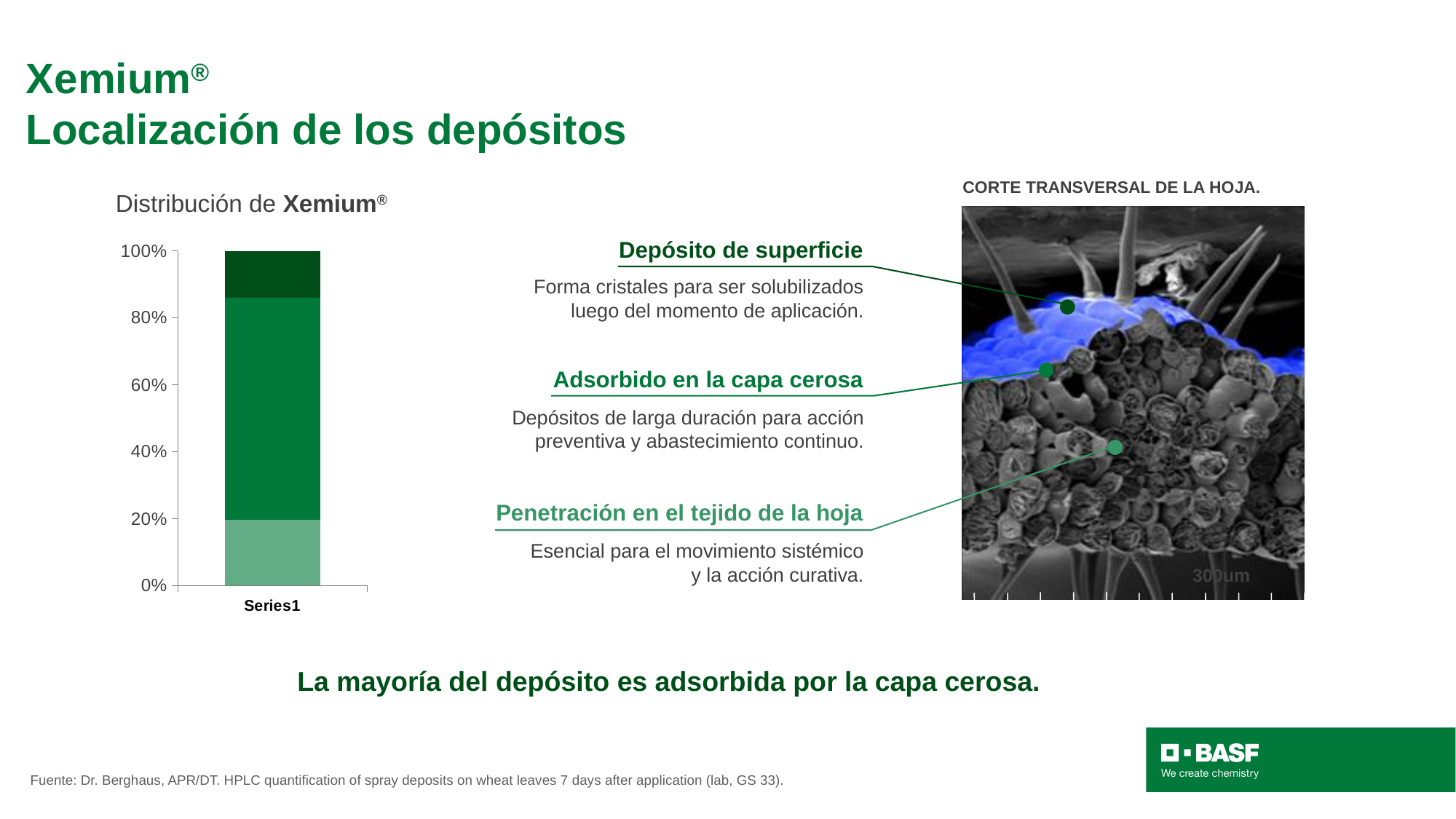
What is the title of the chart on the slide? Distribución de Xemium® Is the middle (medium green) segment of the bar larger or smaller than the bottom (light green) segment? larger What is the label of the single category on the x axis of the chart? Series1 Is the top of the bottom (light green) segment of the bar greater or less than 40%? less Which segment of the stacked bar is the largest: the bottom, middle or top segment? Middle What is the highest value shown on the y axis of the chart? 100% Is the top of the middle (medium green) segment of the bar greater or less than 80%? greater How many segments make up the stacked bar in the chart? 3 What kind of chart is shown on the slide? Stacked bar chart What is the total height of the stacked bar for Series1? 100% How many categories are plotted on the x axis of the chart? 1